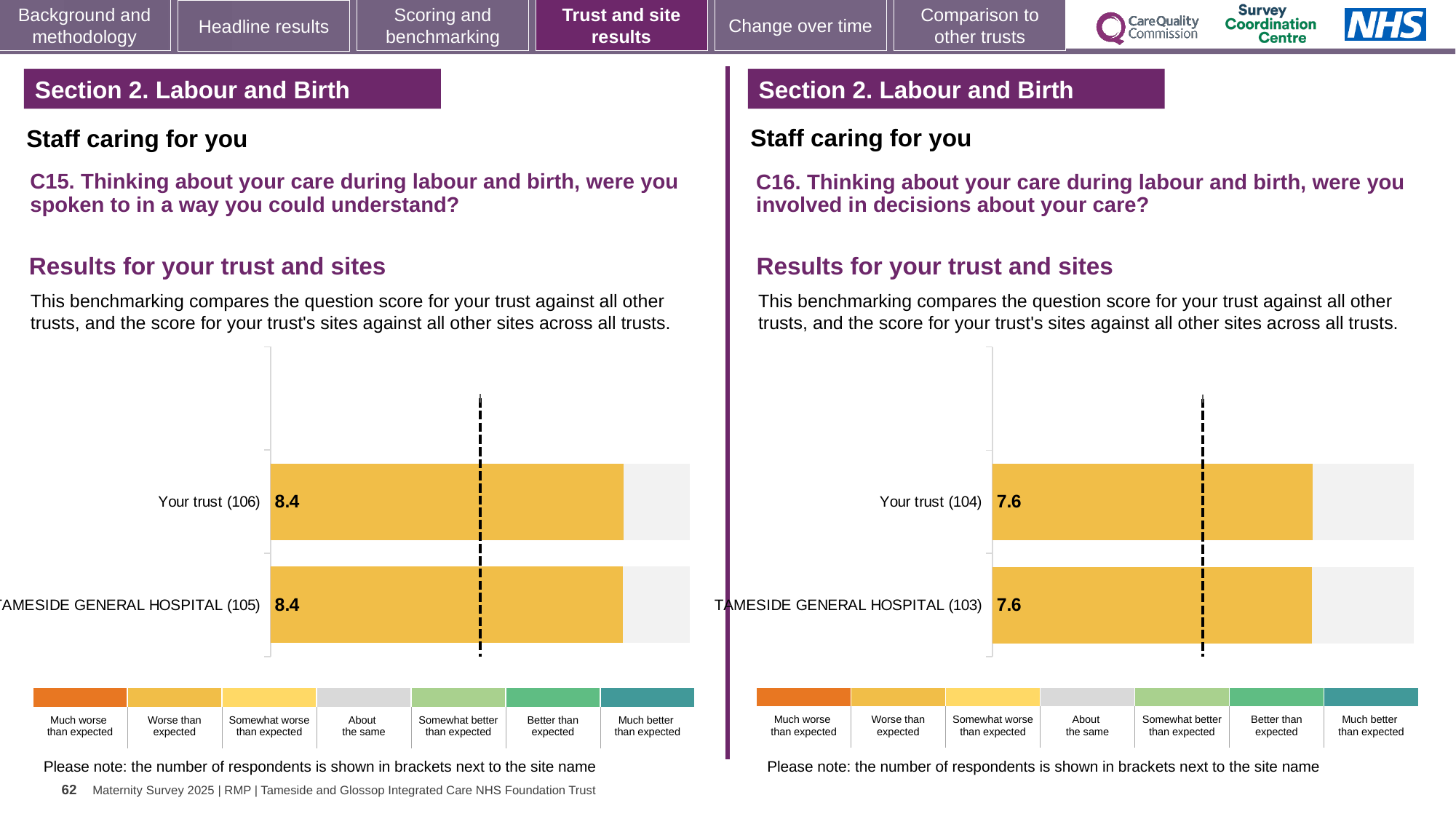
On the left chart (C15), what is the score for Your trust (106)? 8.4 On the left chart (C15), how many respondents are shown in brackets for Your trust? 106 On the left chart (C15), what is the difference between the score for Your trust (106) and the score for TAMESIDE GENERAL HOSPITAL (105)? 0 On the right chart (C16), how many respondents are shown in brackets for TAMESIDE GENERAL HOSPITAL? 103 What kind of chart is used on the left (C15) to show the results for your trust and sites? Bar chart How many bars are plotted on the right chart (C16)? 2 On the right chart (C16), what is the score for TAMESIDE GENERAL HOSPITAL (103)? 7.6 How many bars are plotted on the left chart (C15)? 2 On the right chart (C16), what is the difference between the score for Your trust (104) and the score for TAMESIDE GENERAL HOSPITAL (103)? 0 On the left chart (C15), what is the score for TAMESIDE GENERAL HOSPITAL (105)? 8.4 Which is larger: the Your trust score on the left chart (C15) or the Your trust score on the right chart (C16)? Left chart (C15), 8.4 On the right chart (C16), what is the score for Your trust (104)? 7.6